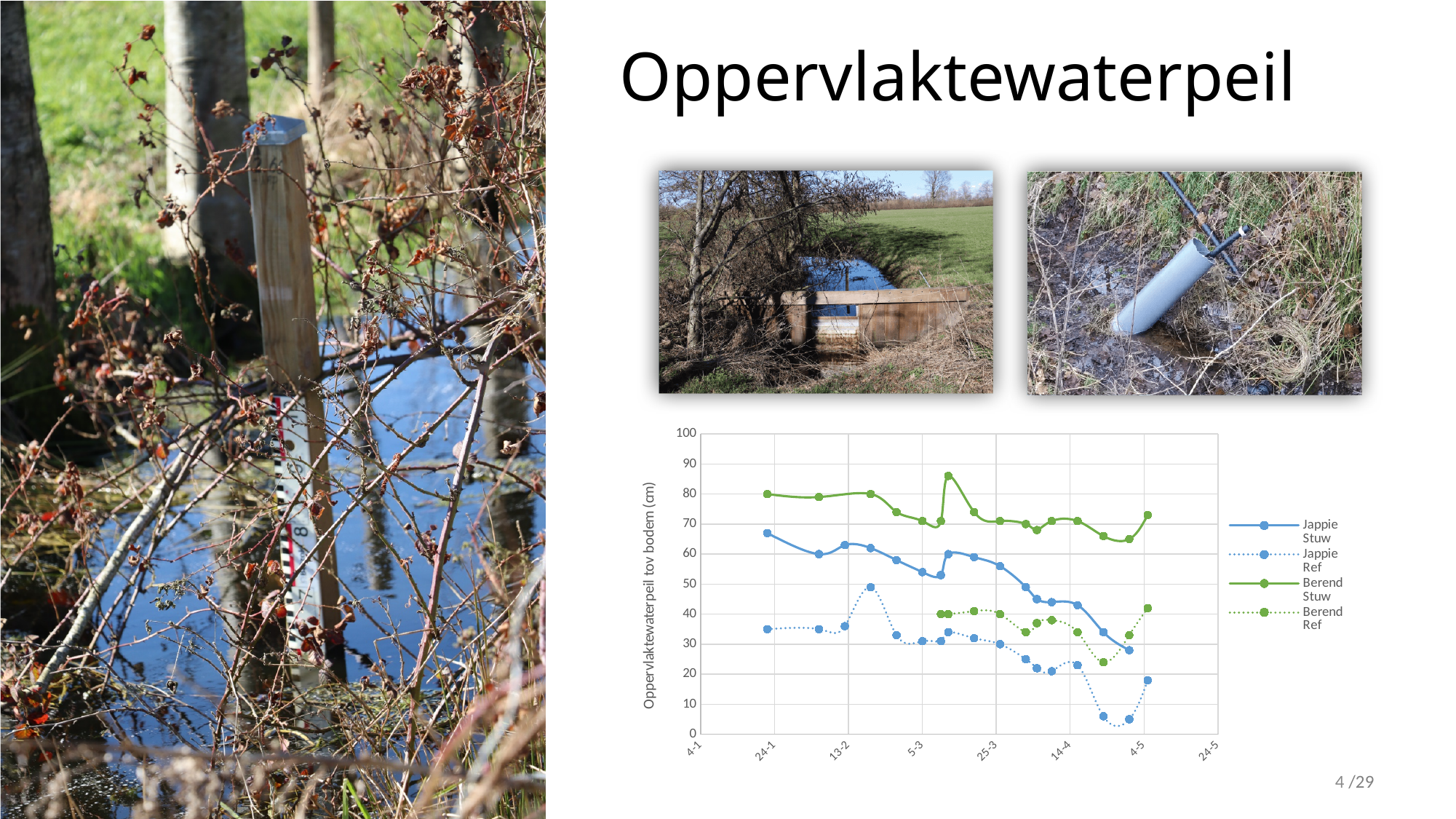
Which series in the chart has the lowest values overall? Jappie Ref What is the label on the vertical axis of the chart? Oppervlaktewaterpeil tov bodem (cm) Which series in the chart has the highest values overall? Berend Stuw Is the peak value of the Berend Stuw series greater or less than 80? greater Is the lowest value of the Jappie Ref series greater or less than 10? less Is the last plotted value of the Jappie Stuw series greater or less than 20? greater How many series does the chart legend list? 4 Which colour is used for the Berend series in the chart? green Which series is higher around 25-3: Berend Stuw or Jappie Stuw? Berend Stuw Does the Jappie Stuw series generally rise or fall from 24-1 to 4-5? fall What kind of chart is shown on the slide? line chart